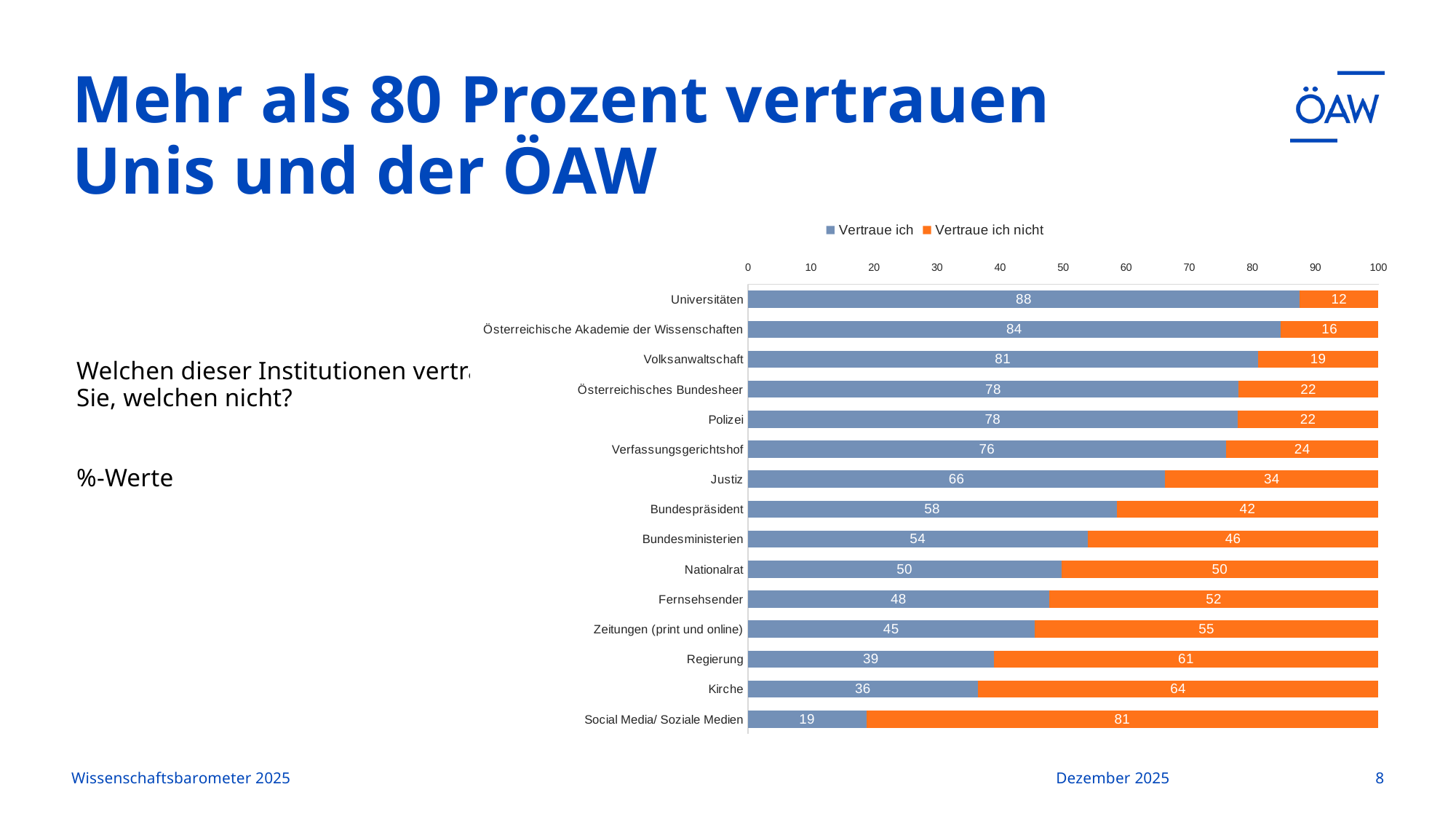
What is the total of the stacked bar for Nationalrat? 100 What is the "Vertraue ich" value for Österreichische Akademie der Wissenschaften? 84 How many institutions are shown in the chart? 15 What kind of chart is shown on the slide? Stacked bar chart Which has a larger "Vertraue ich nicht" value, Regierung or Kirche? Kirche Which institution has the highest "Vertraue ich" value? Universitäten What is the "Vertraue ich" value for Universitäten? 88 Which institution has the lowest "Vertraue ich" value? Social Media/ Soziale Medien What is the difference between the "Vertraue ich" values for Universitäten and Justiz? 22 How many series does the legend list? 2 Which colour represents "Vertraue ich nicht" in the chart? Orange What is the "Vertraue ich nicht" value for Social Media/ Soziale Medien? 81